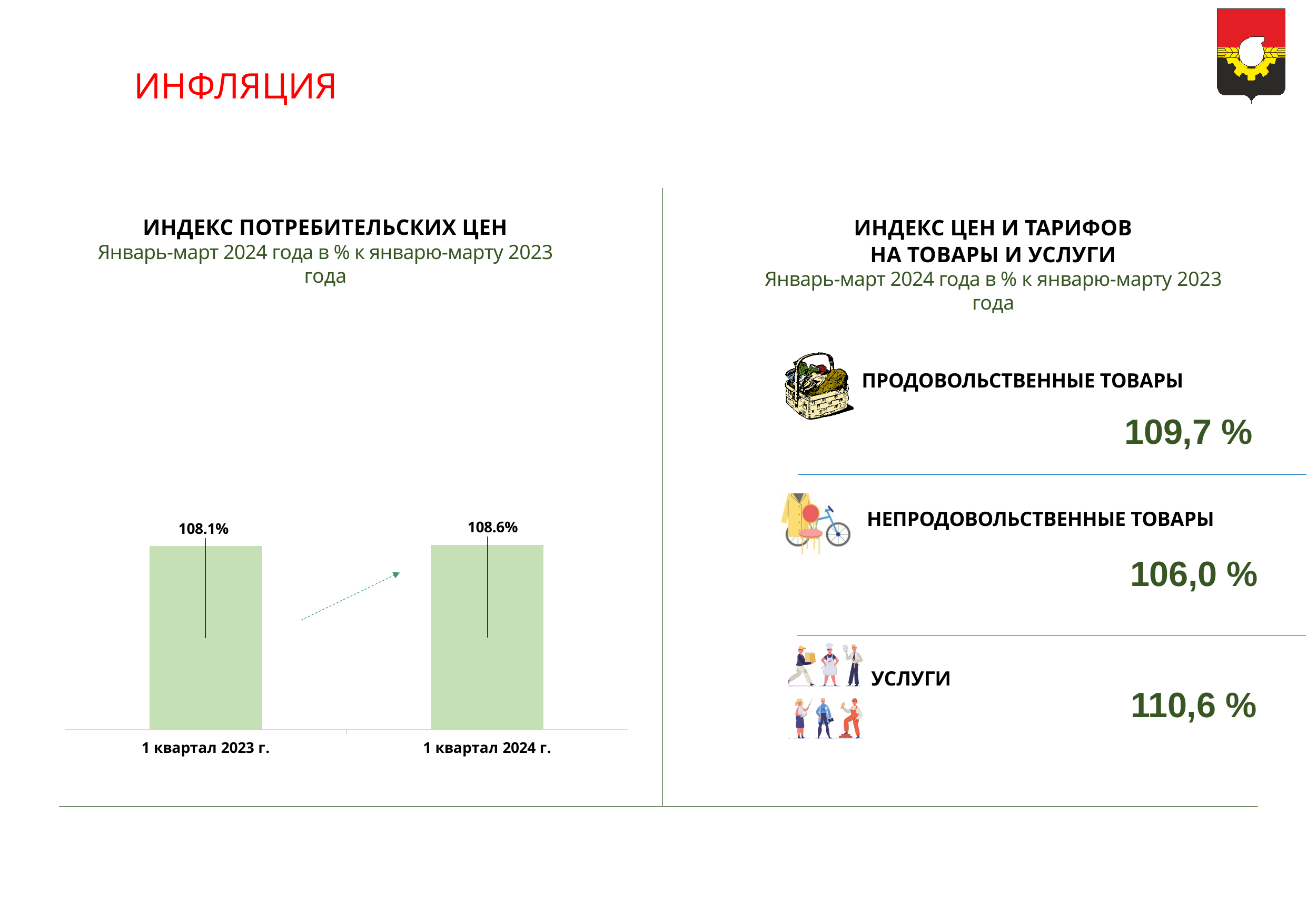
What kind of chart is shown on the left side of the slide? bar chart What is the title of the bar chart? ИНДЕКС ПОТРЕБИТЕЛЬСКИХ ЦЕН In the bar chart, which category has the highest value? 1 квартал 2024 г. In the bar chart, what is the value for 1 квартал 2024 г.? 108.6% In the bar chart, what is the value for 1 квартал 2023 г.? 108.1% What colour are the bars in the bar chart? green In the bar chart, by how many percentage points does the value for 1 квартал 2024 г. exceed the value for 1 квартал 2023 г.? 0.5 In the bar chart, which category has the lowest value? 1 квартал 2023 г. How many bars are shown in the bar chart? 2 In the bar chart, which is larger: the value for 1 квартал 2023 г. or for 1 квартал 2024 г.? 1 квартал 2024 г. In the bar chart, do the values rise or fall from 1 квартал 2023 г. to 1 квартал 2024 г.? rise